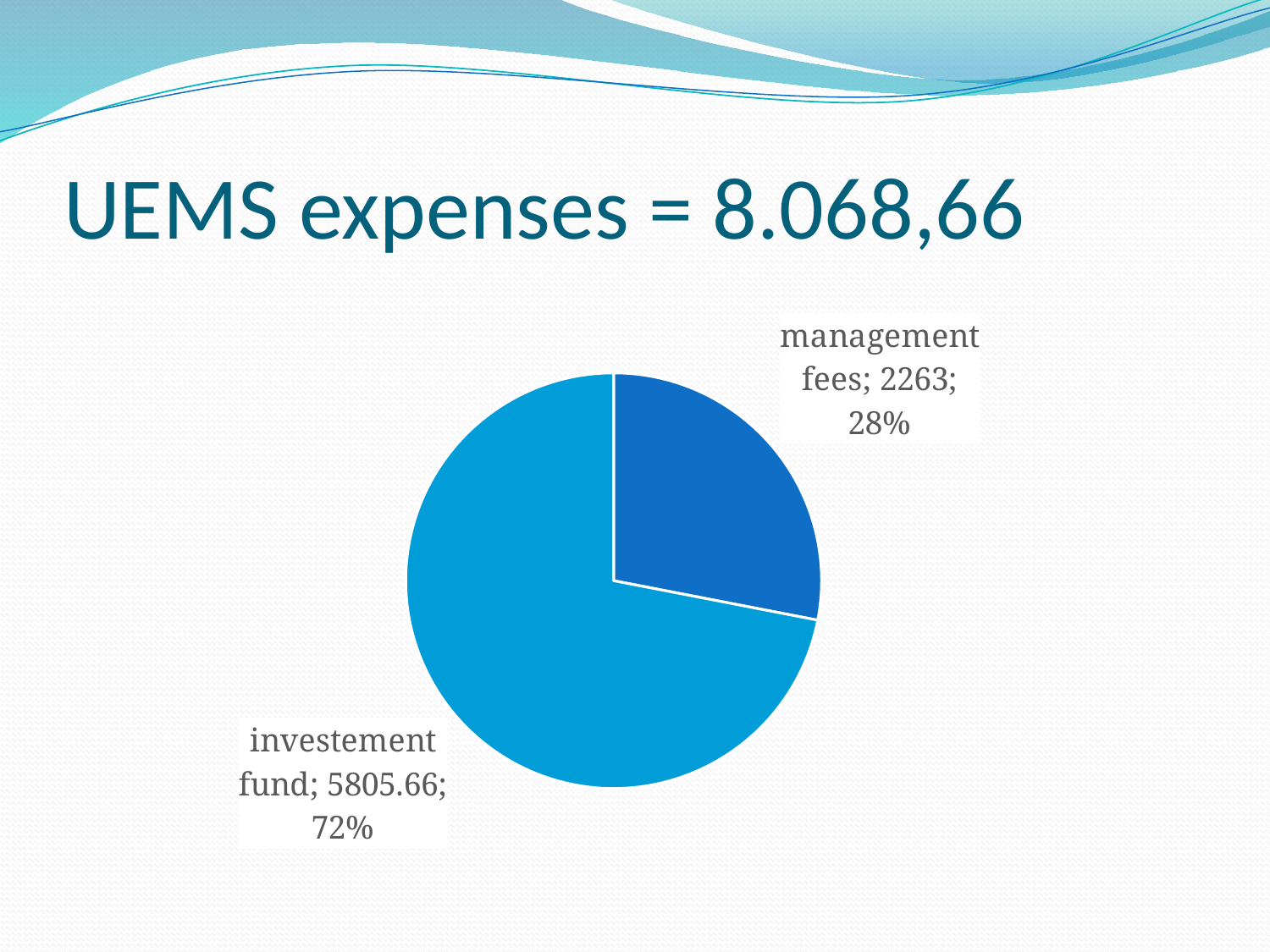
What is the title of the slide containing the chart? UEMS expenses = 8.068,66 What is the value for investement fund? 5805.66 What is the difference in percentage share between investement fund and management fees? 44% Which category has the smallest slice of the pie? management fees Which slice is shown in the darker blue colour? management fees What kind of chart is shown on the slide? pie chart What share of the pie does management fees represent? 28% Which is larger, investement fund or management fees? investement fund What share of the pie does investement fund represent? 72% Which category has the largest slice of the pie? investement fund What is the value for management fees? 2263 How many slices does the pie chart have? 2